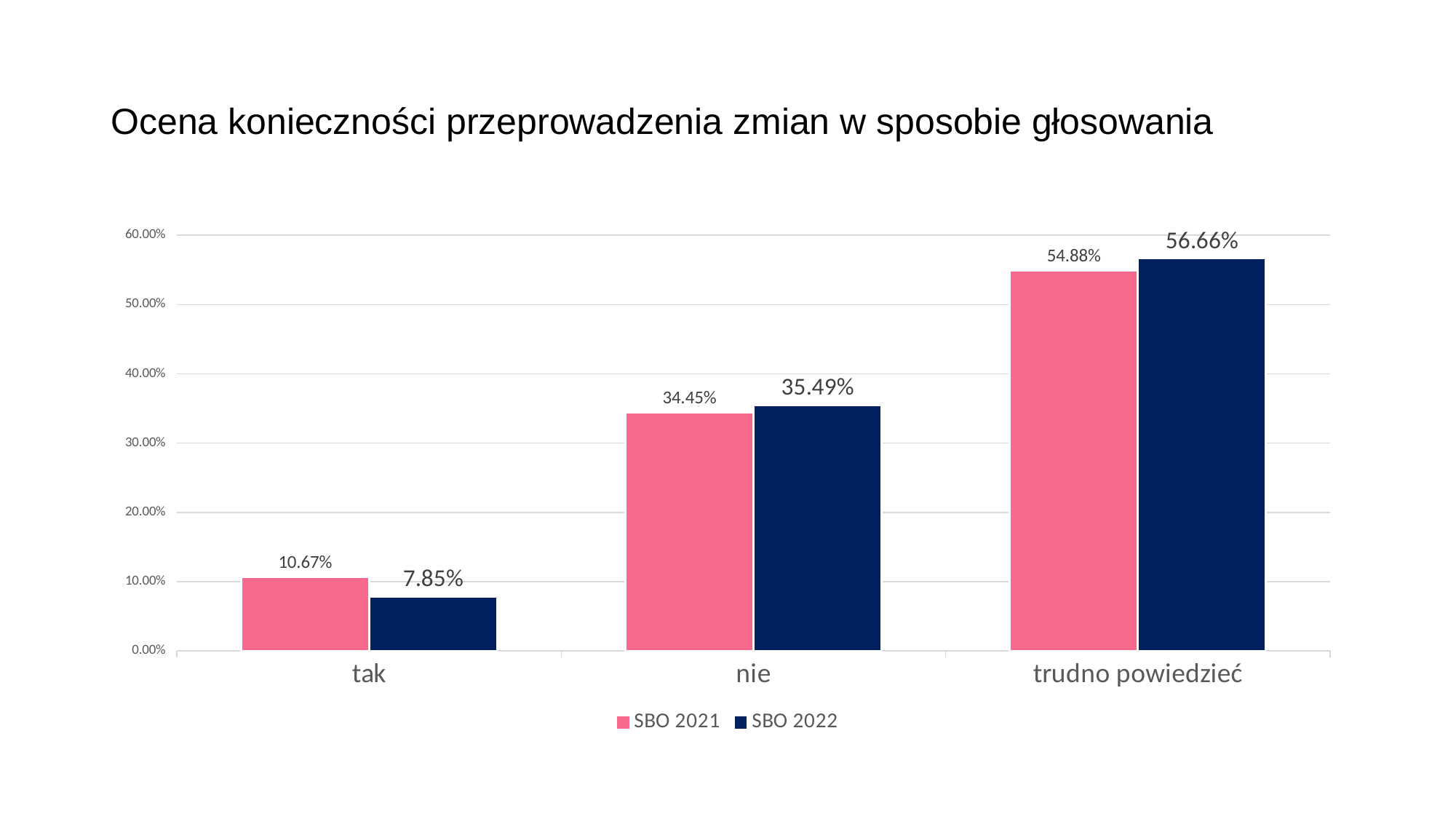
Which category has the highest value in the SBO 2022 series? trudno powiedzieć Which category has the lowest value in the SBO 2021 series? tak What is the value for "trudno powiedzieć" in the SBO 2021 series? 54.88% What is the value for "tak" in the SBO 2021 series? 10.67% What is the difference between the SBO 2022 and SBO 2021 values for "trudno powiedzieć"? 1.78% Which colour represents the SBO 2022 series? dark navy blue Is the SBO 2022 value for "nie" greater or less than 30.00%? greater How many series does the legend list? 2 For "tak", which series has the larger value, SBO 2021 or SBO 2022? SBO 2021 How many categories are shown on the x axis? 3 What kind of chart is shown on the slide? bar chart What is the value for "nie" in the SBO 2022 series? 35.49%